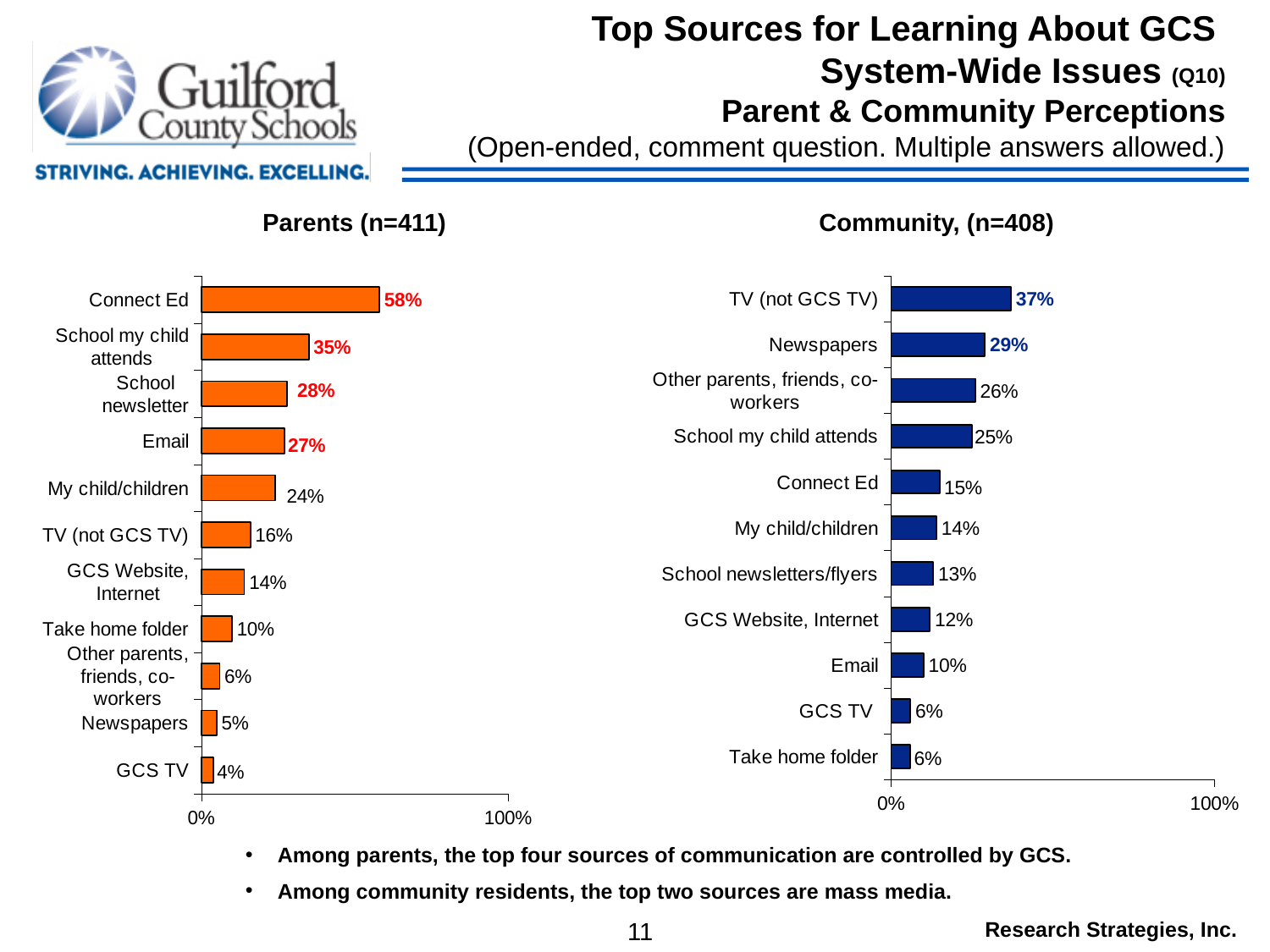
In the Community, (n=408) chart, what is the difference between TV (not GCS TV) and Newspapers? 8 percentage points In the Parents (n=411) chart, which is larger: Email or My child/children? Email In the Community, (n=408) chart, which is larger: Connect Ed or Email? Connect Ed In the Community, (n=408) chart, which source has the lowest value? GCS TV and Take home folder (both 6%) In the Parents (n=411) chart, what is the value for Connect Ed? 58% How many sources are listed in the Community, (n=408) chart? 11 What type of chart is used for the Community, (n=408) data? Bar chart In the Parents (n=411) chart, what is the difference between Connect Ed and School my child attends? 23 percentage points In the Community, (n=408) chart, what is the value for Newspapers? 29% In the Community, (n=408) chart, what is the value for GCS Website, Internet? 12% How many sources are listed in the Parents (n=411) chart? 11 In the Parents (n=411) chart, which source has the highest value? Connect Ed